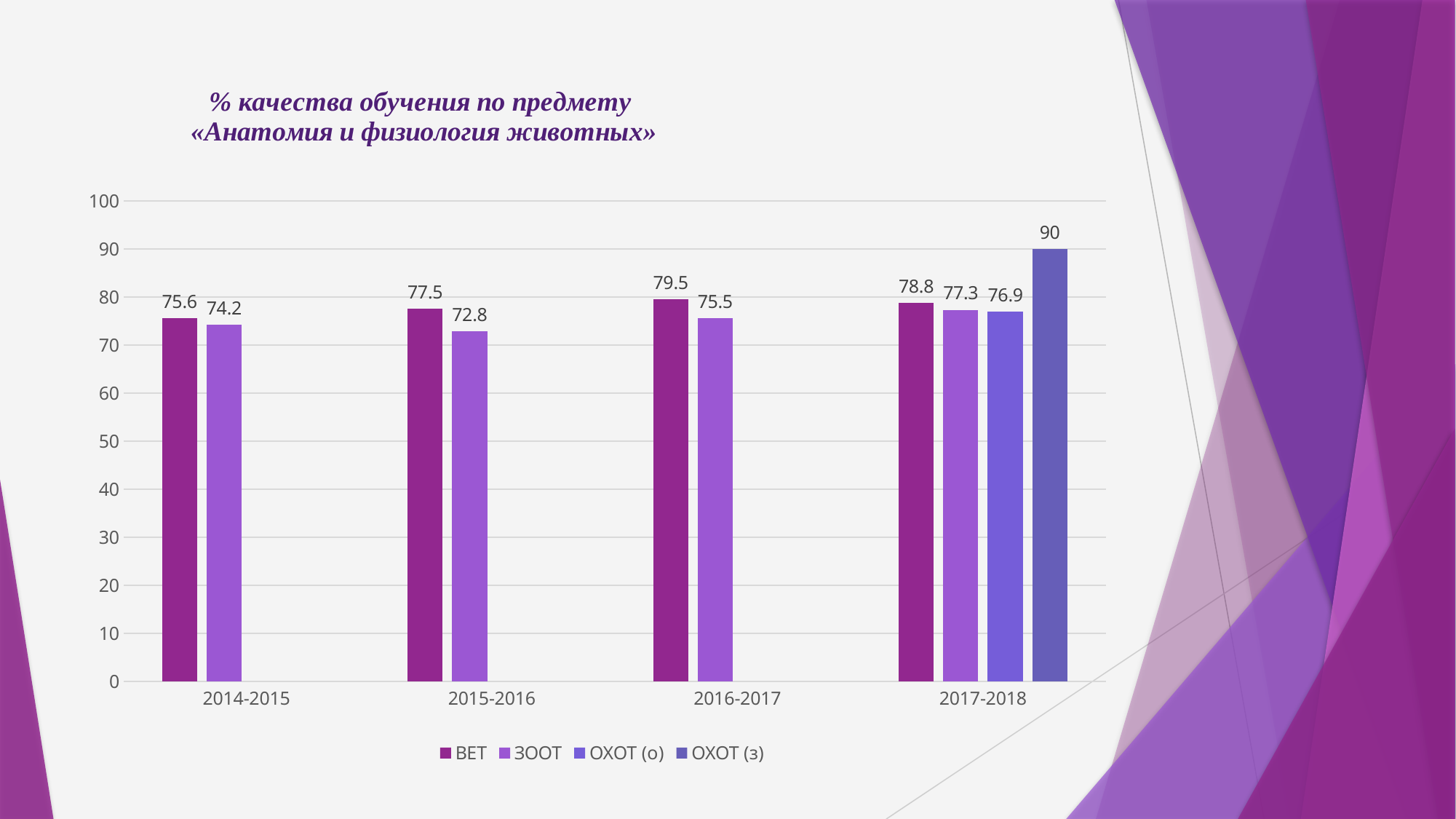
What is the value for ОХОТ (з) in 2017-2018? 90 How many year categories are shown on the x axis? 4 What is the difference between ВЕТ and ЗООТ in 2016-2017? 4 Does the ВЕТ value rise or fall from 2014-2015 to 2016-2017? Rise In which year does ЗООТ have its lowest value? 2015-2016 Which is larger in 2014-2015, ВЕТ or ЗООТ? ВЕТ How many series does the legend list? 4 What kind of chart is shown on the slide? Bar chart What is the value for ВЕТ in 2016-2017? 79.5 What is the value for ЗООТ in 2015-2016? 72.8 What is the value for ОХОТ (о) in 2017-2018? 76.9 Which series has the highest value in 2017-2018? ОХОТ (з)